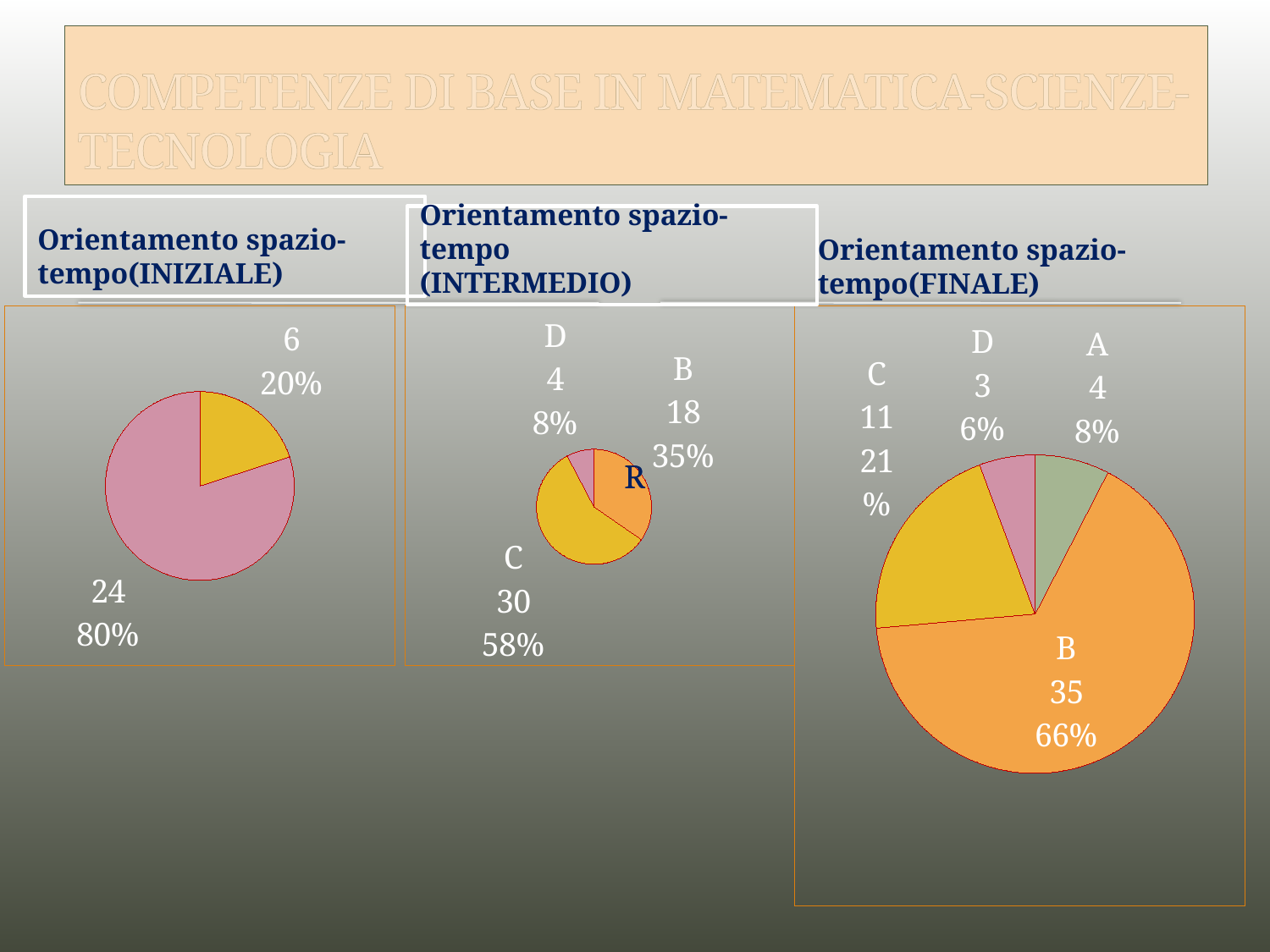
In the 'Orientamento spazio-tempo (INIZIALE)' pie chart, what is the count shown for the smallest slice? 6 What type of chart is used in the 'Orientamento spazio-tempo (INIZIALE)' panel? pie chart In the 'Orientamento spazio-tempo (INTERMEDIO)' pie chart, what is the value for C? 30 In the 'Orientamento spazio-tempo (INIZIALE)' pie chart, how many slices are there? 2 In the 'Orientamento spazio-tempo (FINALE)' pie chart, what is the value for B? 35 In the 'Orientamento spazio-tempo (FINALE)' pie chart, how many categories are shown? 4 In the 'Orientamento spazio-tempo (INIZIALE)' pie chart, what percentage is shown for the largest slice? 80% In the 'Orientamento spazio-tempo (INTERMEDIO)' pie chart, what is the difference between the values for C and B? 12 In the 'Orientamento spazio-tempo (FINALE)' pie chart, which is larger, the value for C or the value for A? C In the 'Orientamento spazio-tempo (FINALE)' pie chart, which category has the largest slice? B In the 'Orientamento spazio-tempo (INTERMEDIO)' pie chart, which category has the smallest slice? D In the 'Orientamento spazio-tempo (INTERMEDIO)' pie chart, what percentage share does B have? 35%